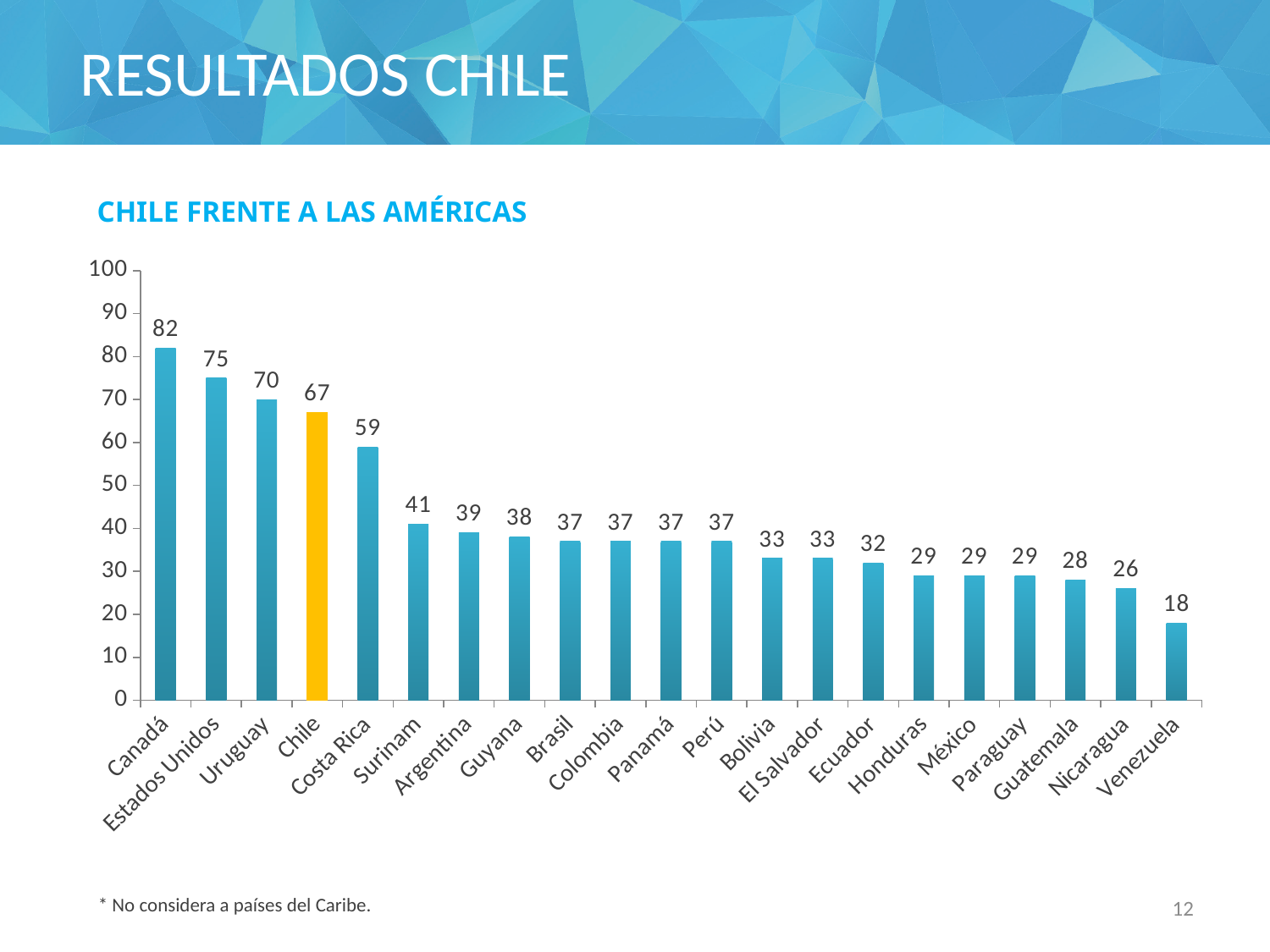
What is the value for Costa Rica? 59 What is the title of the chart? CHILE FRENTE A LAS AMÉRICAS What kind of chart is shown on the slide? Bar chart How many countries are shown in the chart? 21 What is the value for Venezuela? 18 What is the difference between the values for Canadá and Chile? 15 Do the values rise or fall from left to right along the x axis? Fall Which has a larger value, Uruguay or Chile? Uruguay Which country has the highest value? Canadá Which country's bar is highlighted in a different colour (yellow)? Chile Which country has the lowest value? Venezuela What is the value for Chile? 67